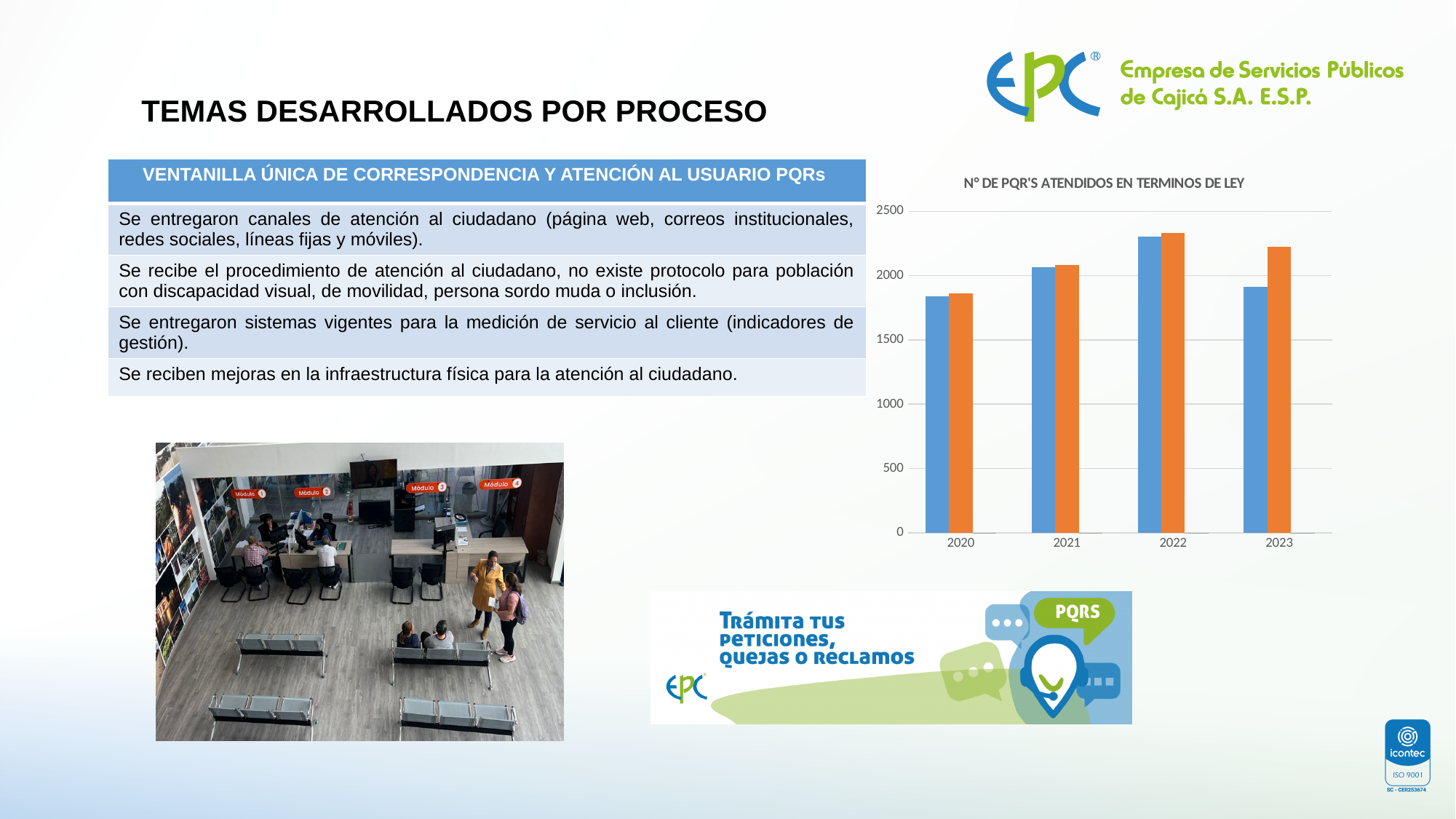
For 2023, which bar is larger, the blue one or the orange one? Orange What is the title of the chart on the slide? N° DE PQR'S ATENDIDOS EN TERMINOS DE LEY What colours are the two bar series in the chart? Blue and orange Which year has the lowest blue bar in the chart? 2020 Is the value of the orange bar for 2022 greater or less than 2000? greater Which year has the highest bars in the chart? 2022 Is the value of the blue bar for 2023 greater or less than 2000? less How many years are shown on the x axis of the chart? 4 What kind of chart is shown under the title "N° DE PQR'S ATENDIDOS EN TERMINOS DE LEY"? Bar chart Is the value of the blue bar for 2020 greater or less than 2000? less Do the values in the chart rise or fall from 2020 to 2022? Rise